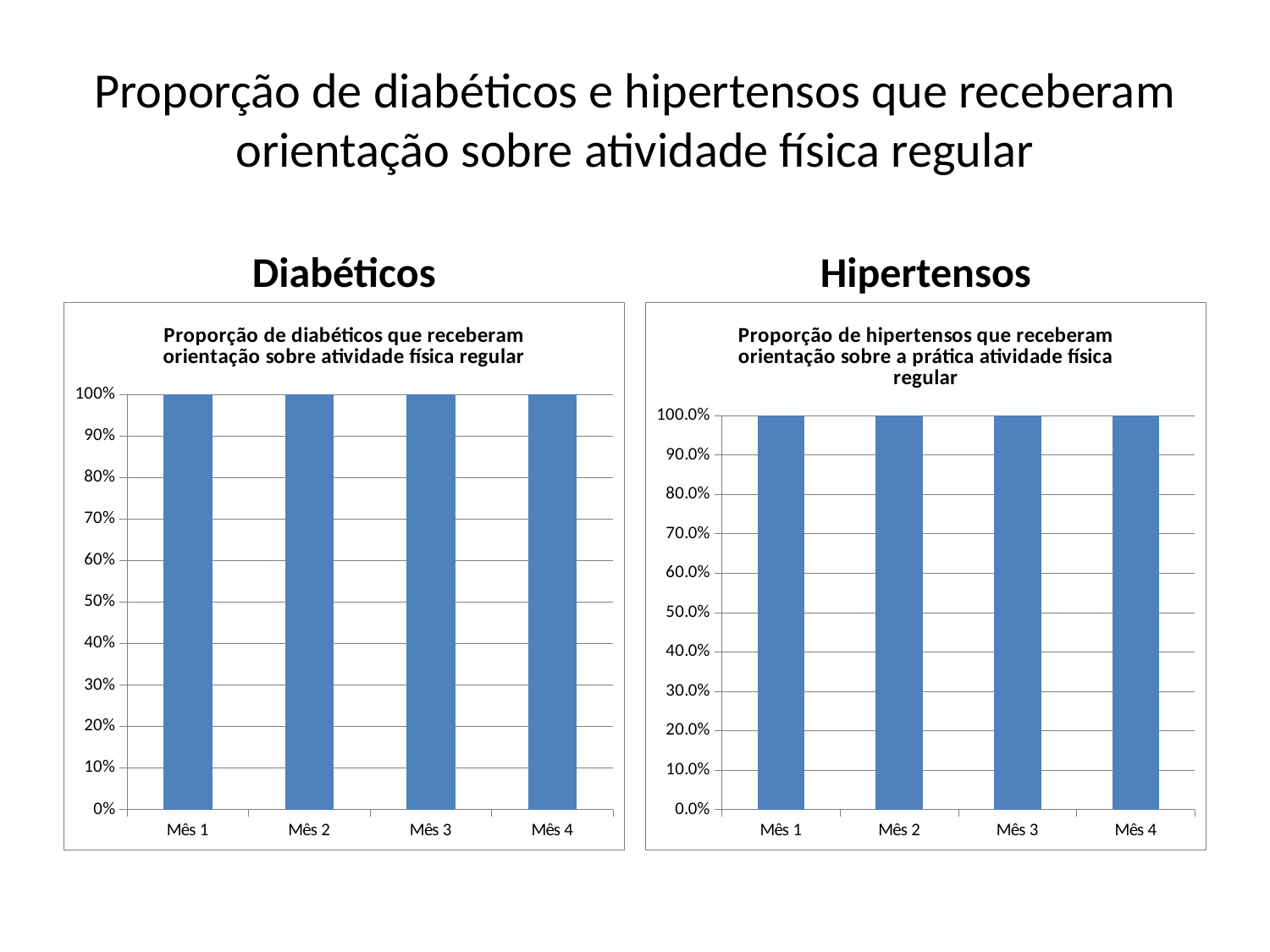
In the Hipertensos chart, what is the value for Mês 2? 100.0% What is the title printed inside the Hipertensos chart? Proporção de hipertensos que receberam orientação sobre a prática atividade física regular In the Hipertensos chart, how many bars are plotted? 4 What kind of chart is the Diabéticos chart? bar chart What kind of chart is the Hipertensos chart? bar chart In the Diabéticos chart, what is the value for Mês 1? 100% In the Hipertensos chart, is the value for Mês 1 greater or less than 50.0%? greater In the Diabéticos chart, what is the value for Mês 4? 100% In the Hipertensos chart, what is the value for Mês 3? 100.0% In the Diabéticos chart, what is the difference between the values for Mês 2 and Mês 3? 0% In the Diabéticos chart, how many months are shown on the x axis? 4 In the Diabéticos chart, do the values rise, fall or stay the same from Mês 1 to Mês 4? stay the same